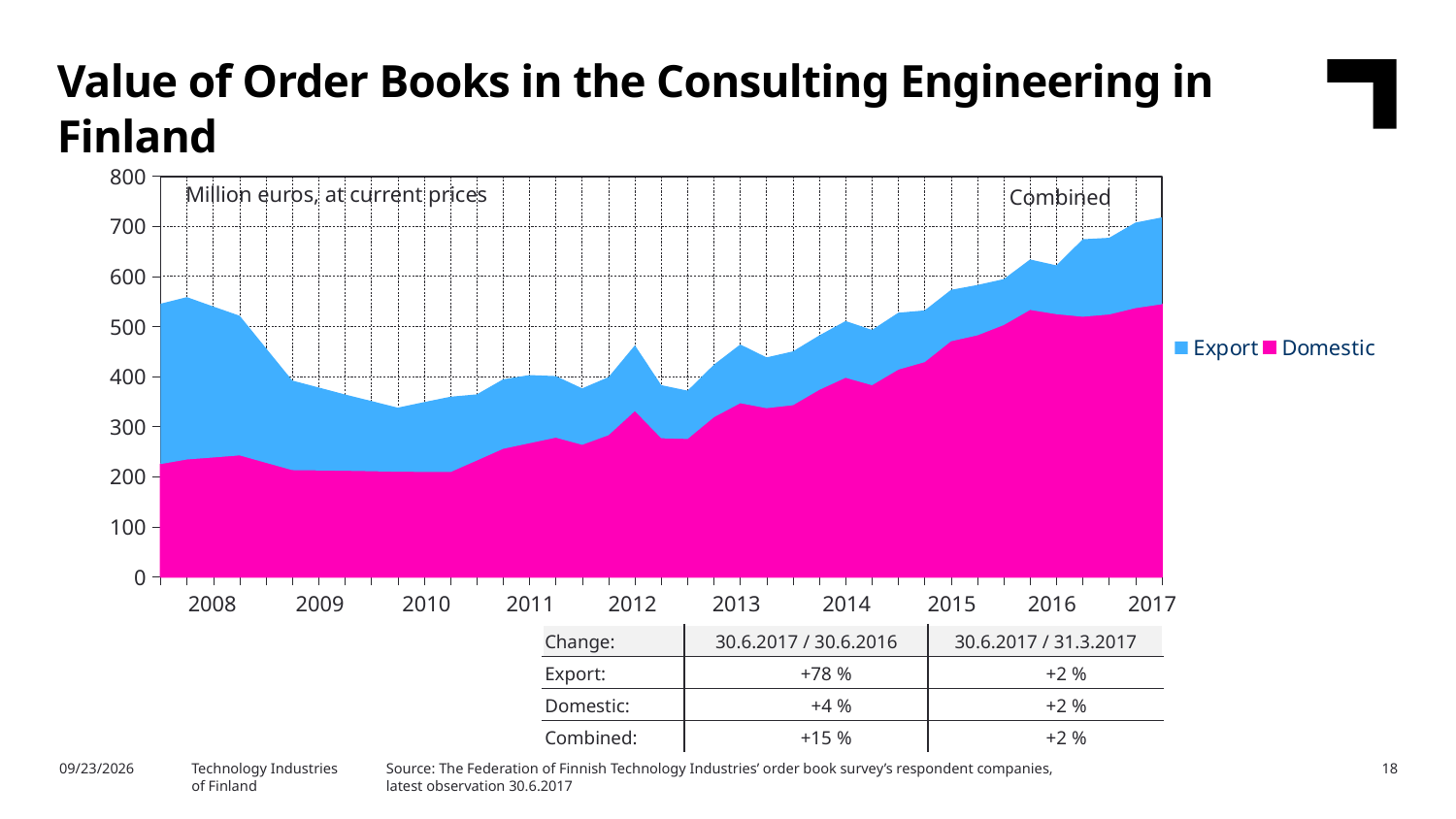
How many series does the chart legend list? 2 Is the Domestic value of order books at the start of 2008 greater or less than 300? less Is the Domestic value of order books at the end of 2017 greater or less than 500? greater Is the combined value of order books in 2010 greater or less than 400? less What kind of chart is shown on the slide? Stacked area chart In what unit are the values on the chart expressed, according to the note inside the plot area? Million euros, at current prices Does the combined value of order books rise or fall between 2010 and 2017? rise Does the combined value of order books rise or fall between 2008 and 2010? fall What are the two series named in the chart legend? Export and Domestic In which year does the combined value of order books reach its highest level on the chart? 2017